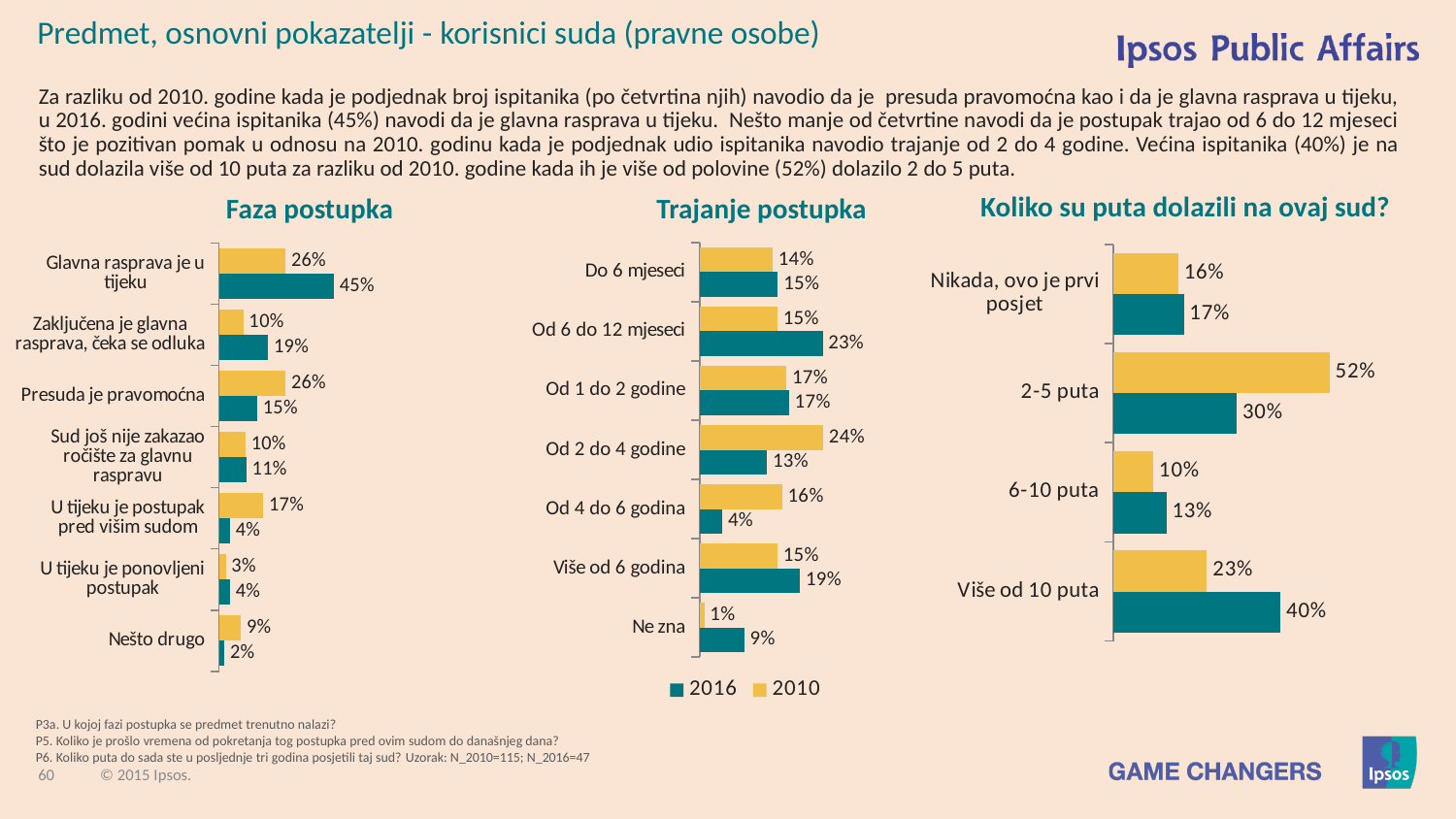
In the 'Koliko su puta dolazili na ovaj sud?' chart, what is the 2010 value for '2-5 puta'? 52% In the 'Faza postupka' chart, what is the difference between the 2016 and 2010 values for 'U tijeku je postupak pred višim sudom'? 13 percentage points In the 'Trajanje postupka' chart, which category has the lowest 2010 value? Ne zna How many categories are shown in the 'Trajanje postupka' chart? 7 What type of chart is the 'Faza postupka' chart? Bar chart How many series does the legend list for the charts on this slide? 2 In the 'Faza postupka' chart, what is the 2010 value for 'Presuda je pravomoćna'? 26% In the 'Faza postupka' chart, which category has the highest 2016 value? Glavna rasprava je u tijeku In the 'Faza postupka' chart, what is the 2016 value for 'Glavna rasprava je u tijeku'? 45% In the 'Trajanje postupka' chart, which is larger for 'Od 2 do 4 godine': the 2010 value or the 2016 value? 2010 In the 'Trajanje postupka' chart, what is the 2016 value for 'Od 6 do 12 mjeseci'? 23% In the 'Koliko su puta dolazili na ovaj sud?' chart, which category has the highest 2016 value? Više od 10 puta